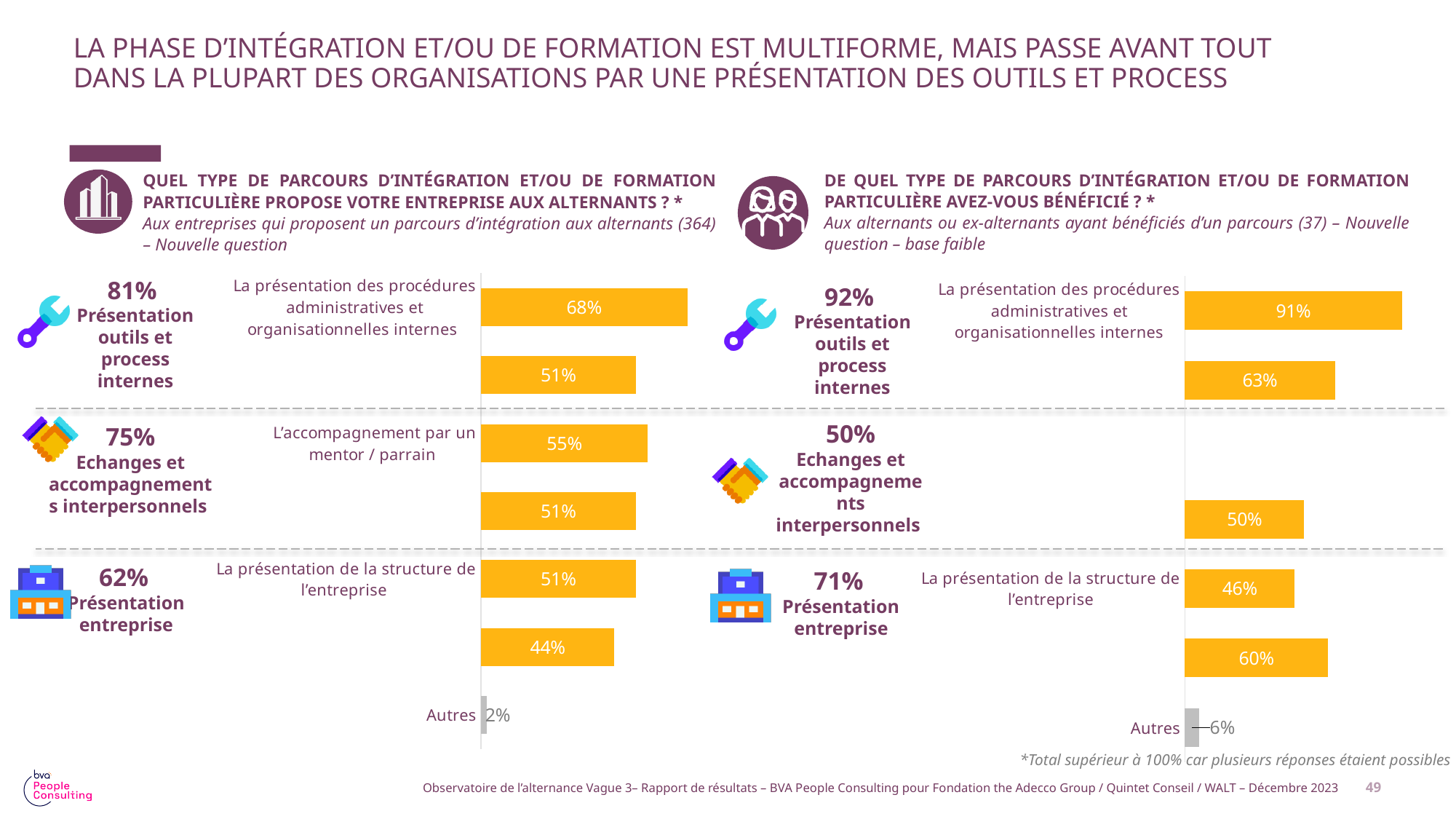
In the right chart (alternants), what value is shown for 'Autres'? 6% What is the difference between the value for 'La présentation des procédures administratives et organisationnelles internes' in the right chart (91%) and in the left chart (68%)? 23% In the left chart (entreprises), what value is shown for 'Autres'? 2% In the left chart (entreprises), what value is shown for 'La présentation des procédures administratives et organisationnelles internes'? 68% In the left chart (entreprises), what value is shown for 'L'accompagnement par un mentor / parrain'? 55% Which is larger: 'La présentation de la structure de l'entreprise' in the left chart or in the right chart? Left chart (51%) In the right chart (alternants), what value is shown for 'La présentation de la structure de l'entreprise'? 46% In the right chart (alternants), what value is shown for 'La présentation des procédures administratives et organisationnelles internes'? 91% In the left chart (entreprises), what value is shown for 'La présentation de la structure de l'entreprise'? 51% In the right chart (alternants), which labelled category has the highest value? La présentation des procédures administratives et organisationnelles internes What type of chart is used on this slide? Bar chart In the left chart (entreprises), which labelled category has the lowest value? Autres